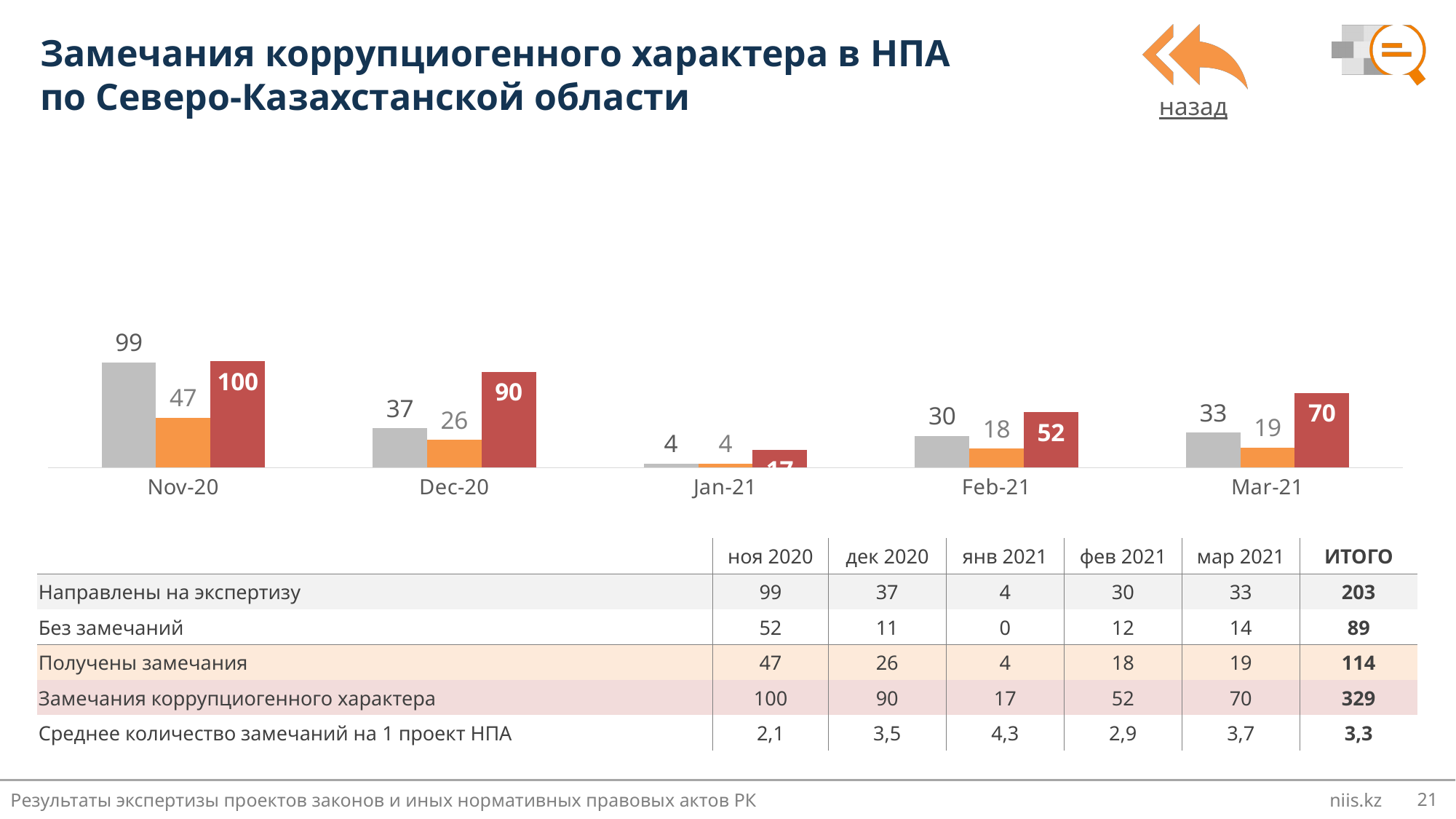
What kind of chart is shown on the slide? bar chart In which month is the grey bar the highest? Nov-20 What is the difference between the red bar values for Nov-20 and Dec-20? 10 Which is larger for Feb-21: the grey bar or the red bar? the red bar What is the value of the orange bar for Feb-21? 18 In which month is the red bar the lowest? Jan-21 What is the value of the grey bar for Dec-20? 37 How many differently coloured bars are shown for each month in the chart? 3 What is the value of the red bar for Mar-21? 70 How many months are shown on the x axis of the chart? 5 Do the grey bar values rise or fall from Nov-20 to Jan-21? fall What is the value of the red bar for Nov-20? 100